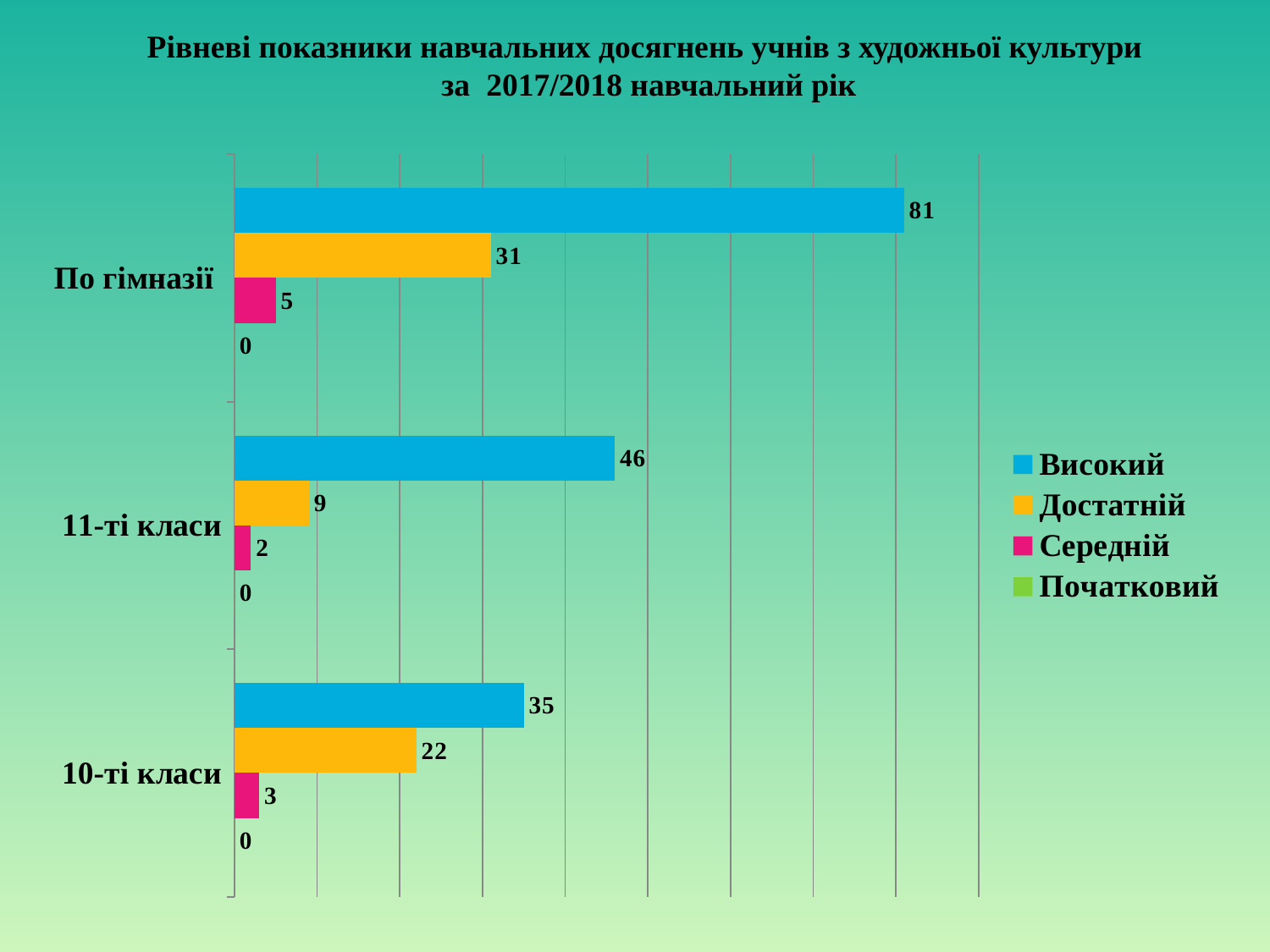
What is the value for Середній in the 11-ті класи category? 2 What is the value for Достатній in the 10-ті класи category? 22 What is the value for Високий in the По гімназії category? 81 What is the value for Початковий in the 10-ті класи category? 0 What is the difference between the Високий values for 11-ті класи and 10-ті класи? 11 What kind of chart is shown on the slide? Bar chart Which legend entry is shown in yellow? Достатній Which category has the highest value for Високий? По гімназії Which category has the lowest value for Достатній? 11-ті класи Which is larger: Достатній for 10-ті класи or Достатній for 11-ті класи? 10-ті класи How many categories are shown on the vertical axis? 3 How many series does the legend list? 4